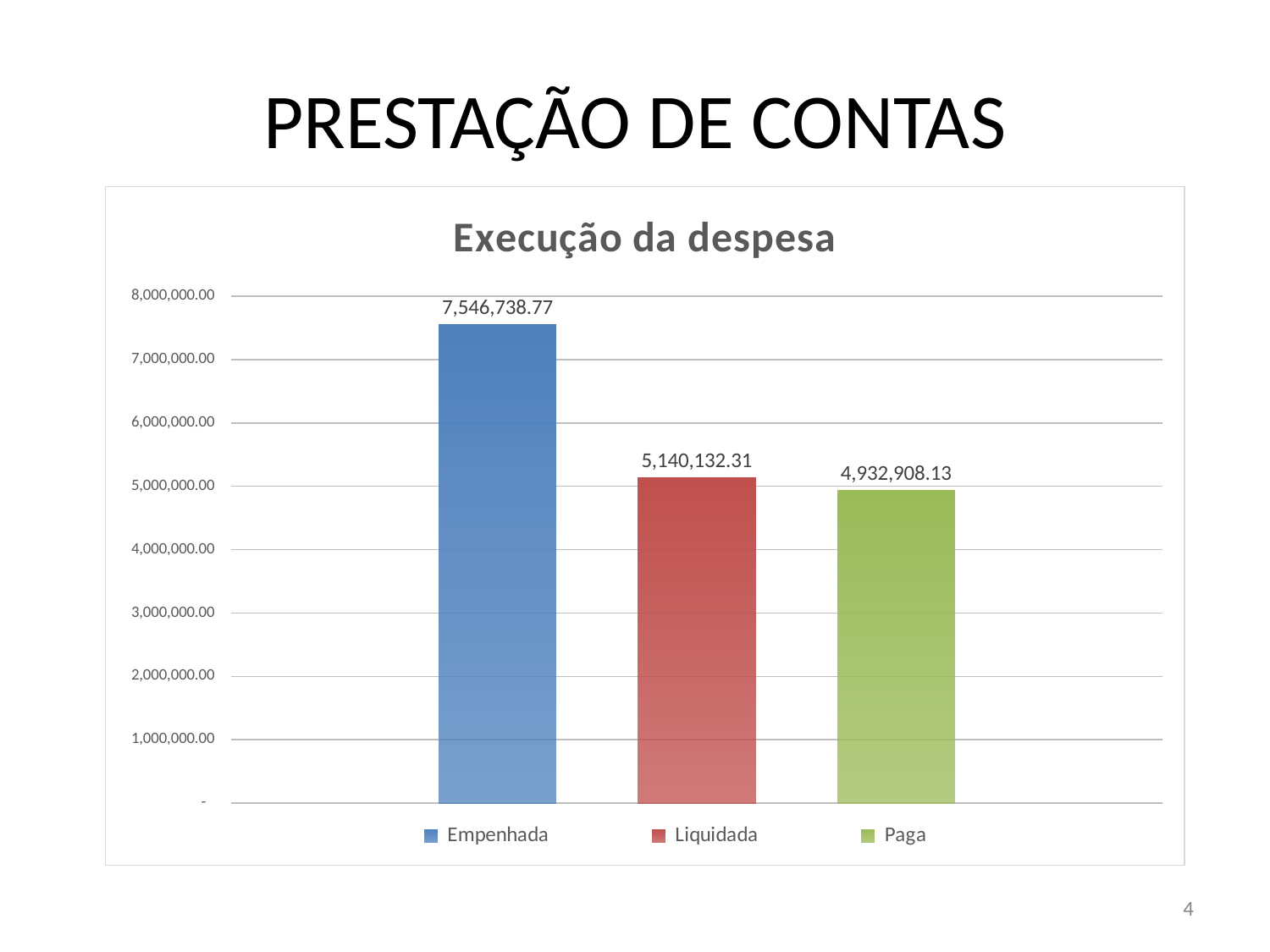
What is the difference between the Empenhada and Liquidada values? 2,406,606.46 What type of chart is shown on the slide? Bar chart What is the difference between the Liquidada and Paga values? 207,224.18 How many bars are plotted in the chart? 3 What is the value of the Empenhada bar in the Execução da despesa chart? 7,546,738.77 What is the value of the Paga bar? 4,932,908.13 Which series has the highest value in the chart? Empenhada How many series does the legend list? 3 Which is larger, the Liquidada value or the Paga value? Liquidada What is the value of the Liquidada bar? 5,140,132.31 Is the value for Empenhada greater or less than 7,000,000.00? greater Which series has the lowest value in the chart? Paga